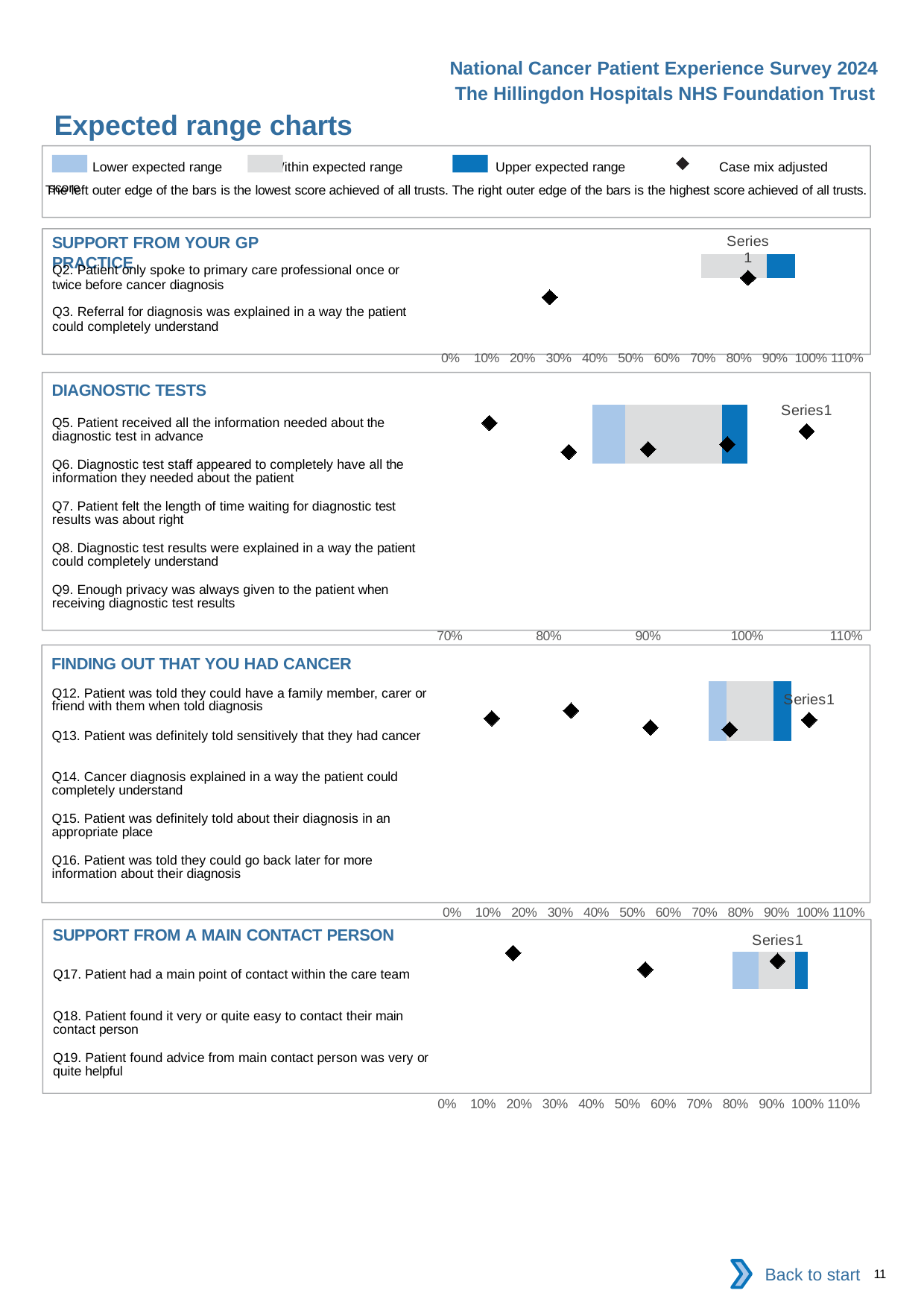
How many diamond markers are plotted in the 'DIAGNOSTIC TESTS' chart? 5 How many questions are listed in the 'DIAGNOSTIC TESTS' chart? 5 According to the legend, which colour represents the upper expected range? dark blue What kind of chart is used in the 'DIAGNOSTIC TESTS' section? bar chart How many questions are listed in the 'SUPPORT FROM YOUR GP PRACTICE' chart? 2 In the 'FINDING OUT THAT YOU HAD CANCER' chart, is the rightmost diamond marker greater or less than 80%? greater According to the legend, what does the black diamond marker represent? Case mix adjusted score In the 'SUPPORT FROM A MAIN CONTACT PERSON' chart, is the leftmost diamond marker greater or less than 30%? less In the 'FINDING OUT THAT YOU HAD CANCER' chart, is the leftmost diamond marker greater or less than 20%? less